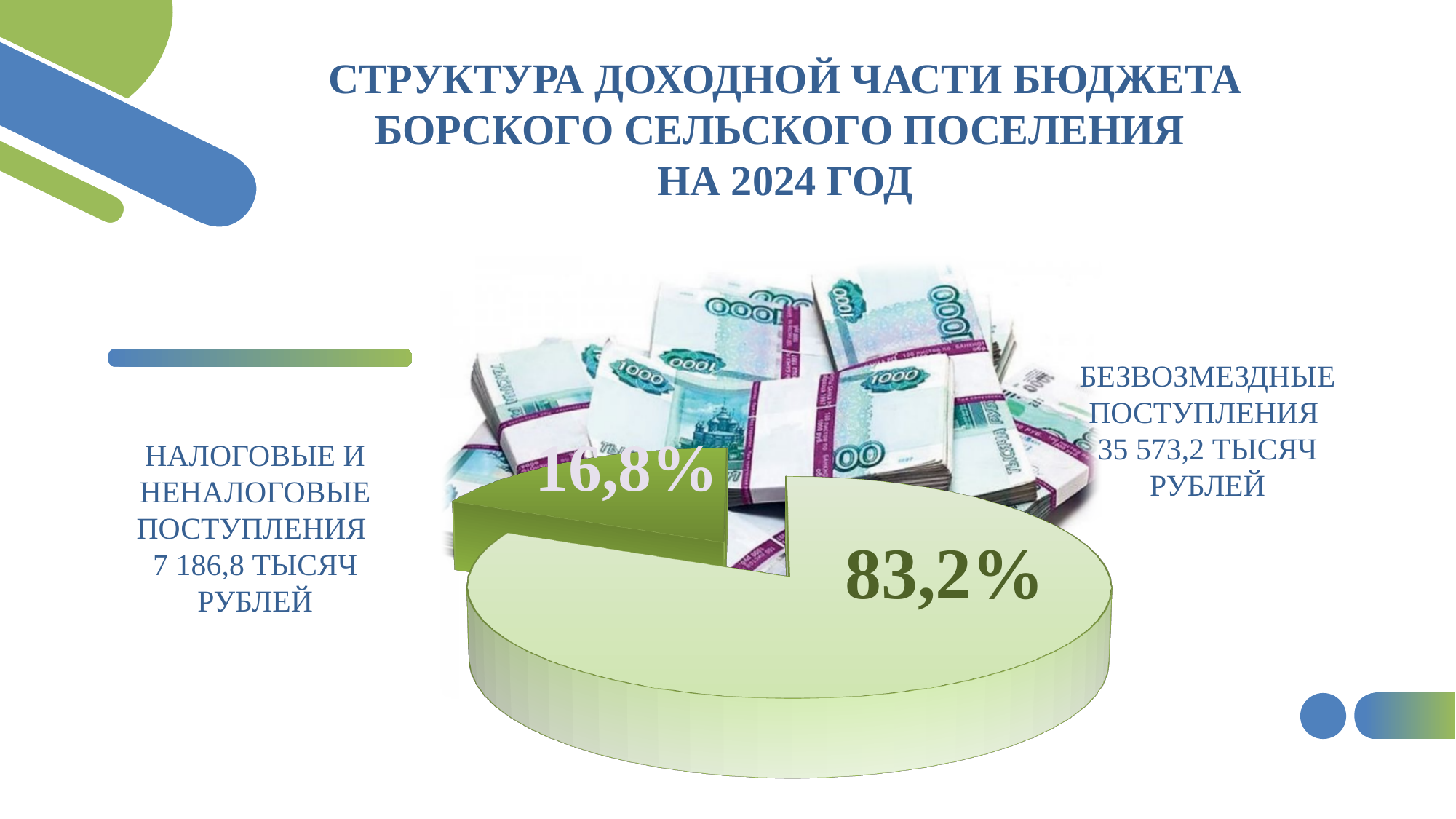
What share of the pie does the slice for НАЛОГОВЫЕ И НЕНАЛОГОВЫЕ ПОСТУПЛЕНИЯ represent? 16,8% By how many percentage points does the share of БЕЗВОЗМЕЗДНЫЕ ПОСТУПЛЕНИЯ exceed the share of НАЛОГОВЫЕ И НЕНАЛОГОВЫЕ ПОСТУПЛЕНИЯ? 66,4 Which category has the smallest slice of the pie? НАЛОГОВЫЕ И НЕНАЛОГОВЫЕ ПОСТУПЛЕНИЯ Which is larger: the share of НАЛОГОВЫЕ И НЕНАЛОГОВЫЕ ПОСТУПЛЕНИЯ or the share of БЕЗВОЗМЕЗДНЫЕ ПОСТУПЛЕНИЯ? БЕЗВОЗМЕЗДНЫЕ ПОСТУПЛЕНИЯ What is the amount shown for БЕЗВОЗМЕЗДНЫЕ ПОСТУПЛЕНИЯ? 35 573,2 тысяч рублей What share of the pie does the slice for БЕЗВОЗМЕЗДНЫЕ ПОСТУПЛЕНИЯ represent? 83,2% How many slices does the pie chart have? 2 Which category has the largest slice of the pie? БЕЗВОЗМЕЗДНЫЕ ПОСТУПЛЕНИЯ For which year does the slide title say the budget revenue structure is shown? 2024 What is the amount shown for НАЛОГОВЫЕ И НЕНАЛОГОВЫЕ ПОСТУПЛЕНИЯ? 7 186,8 тысяч рублей What is the difference in thousands of rubles between БЕЗВОЗМЕЗДНЫЕ ПОСТУПЛЕНИЯ and НАЛОГОВЫЕ И НЕНАЛОГОВЫЕ ПОСТУПЛЕНИЯ? 28 386,4 тысяч рублей What type of chart is shown on the slide? Pie chart